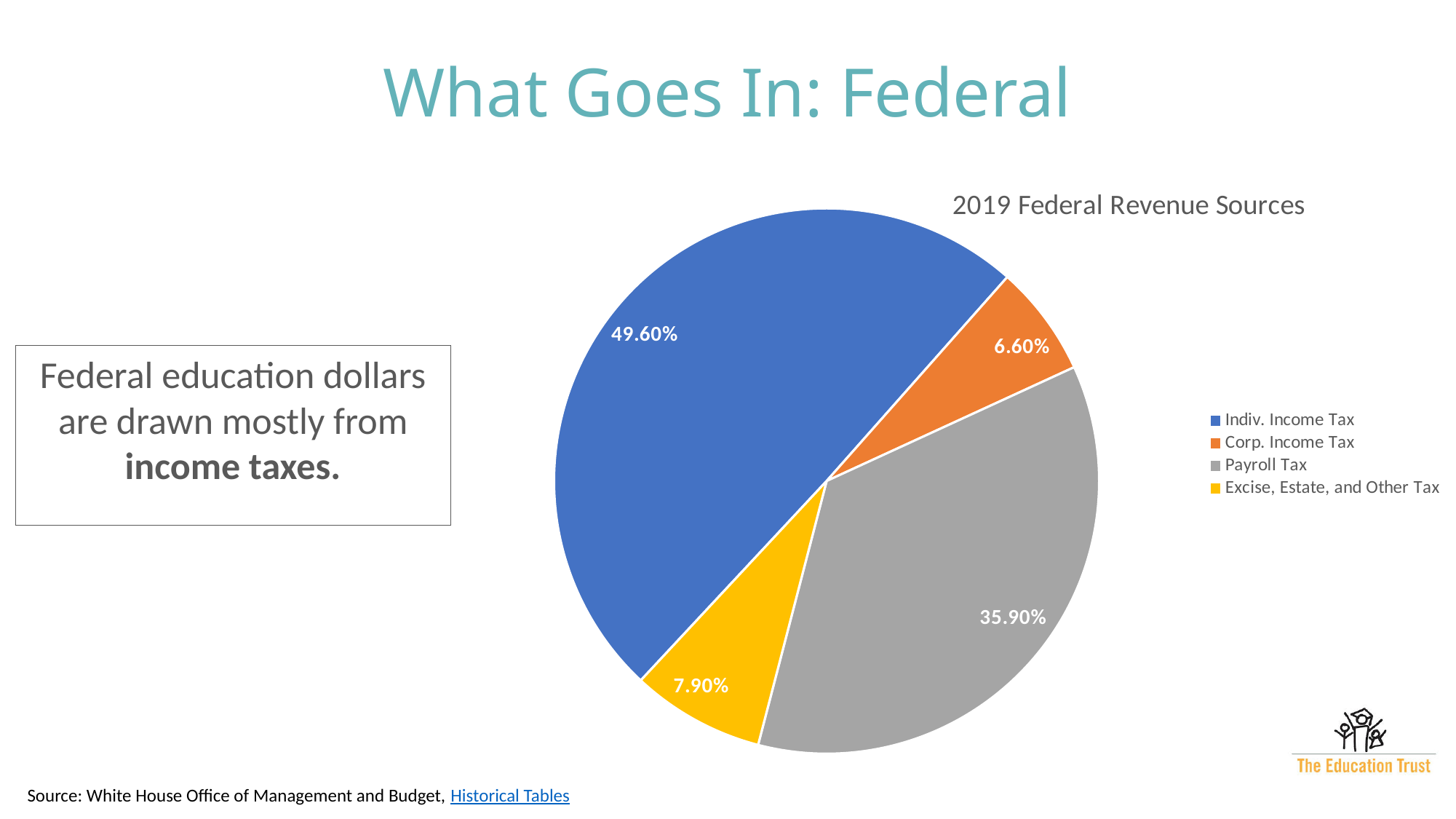
How many revenue sources are shown in the pie chart? 4 What share of 2019 federal revenue comes from Corp. Income Tax? 6.60% What is the difference in percentage points between Indiv. Income Tax and Payroll Tax? 13.70% What share of 2019 federal revenue comes from Payroll Tax? 35.90% What colour is the Payroll Tax slice? Gray Which is larger, the share for Excise, Estate, and Other Tax or the share for Corp. Income Tax? Excise, Estate, and Other Tax What share of 2019 federal revenue comes from Indiv. Income Tax? 49.60% What is the title of the chart? 2019 Federal Revenue Sources What kind of chart is shown on the slide? Pie chart Which revenue source has the smallest share of the pie? Corp. Income Tax What share of 2019 federal revenue comes from Excise, Estate, and Other Tax? 7.90% Which revenue source has the largest share of the pie? Indiv. Income Tax